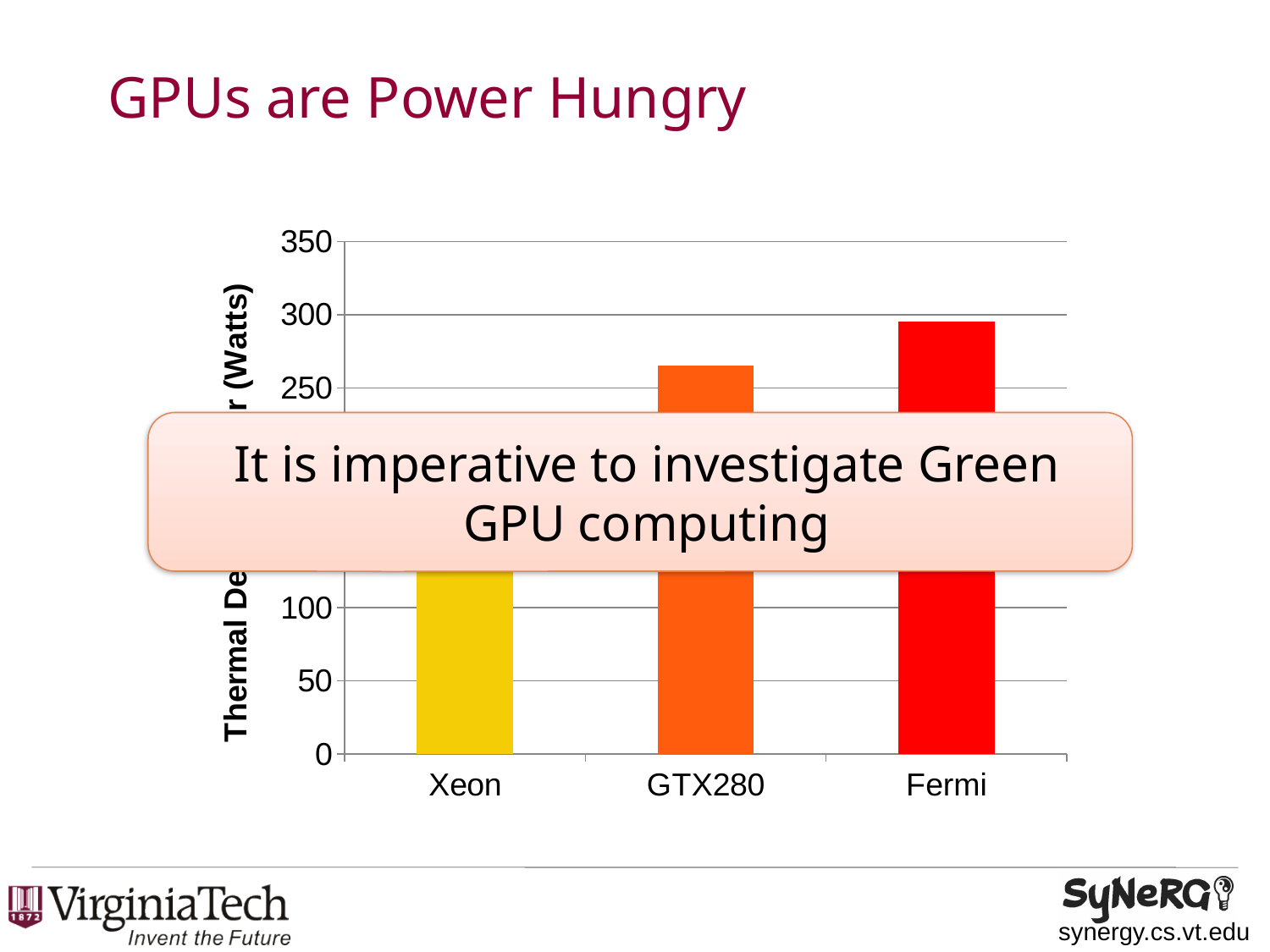
Is the value for Fermi greater or less than 300? less Which category has the highest bar in the chart? Fermi What kind of chart is shown on the slide? bar chart Which category has the lowest bar in the chart? Xeon Which has a higher value, Xeon or GTX280? GTX280 What is the title of the slide containing the chart? GPUs are Power Hungry Is the value for Fermi greater or less than 250? greater How many categories are plotted on the x axis of the chart? 3 Which has a higher value, GTX280 or Fermi? Fermi Is the value for Xeon greater or less than 250? less Do the bar values rise or fall from left to right across the x axis? rise